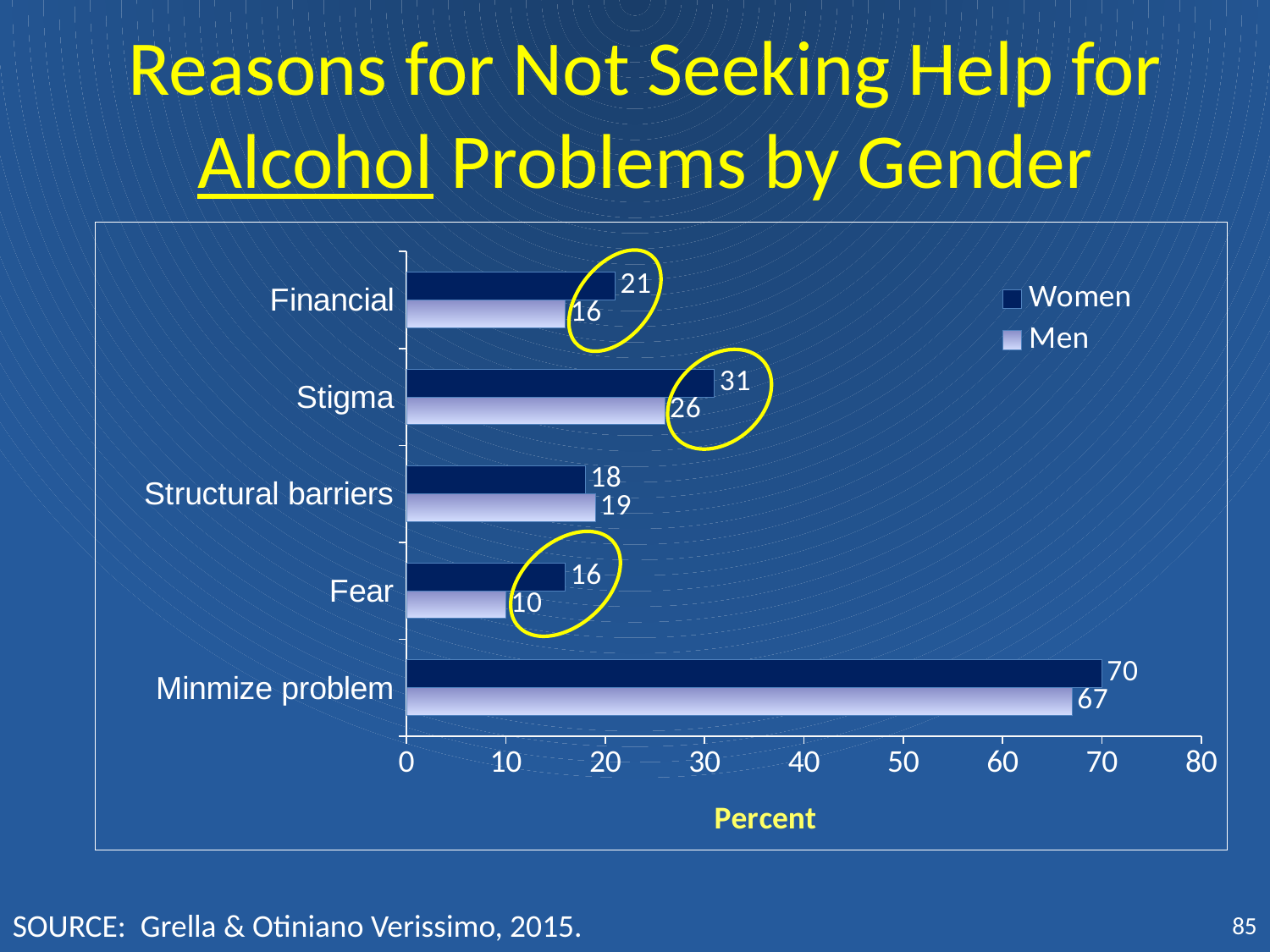
What is the difference between the Women and Men values for Stigma? 5 What is the difference between the Women and Men values for Financial? 5 What kind of chart is shown on the slide? Bar chart What is the value for Women for Stigma? 31 What is the label of the horizontal axis? Percent Which category has the lowest value for Men? Fear What is the value for Men for Fear? 10 Which category has the highest value for Women? Minmize problem How many categories are shown on the chart? 5 For Structural barriers, which is larger, the value for Women or the value for Men? Men What is the value for Men for Minmize problem? 67 How many series does the legend list? 2